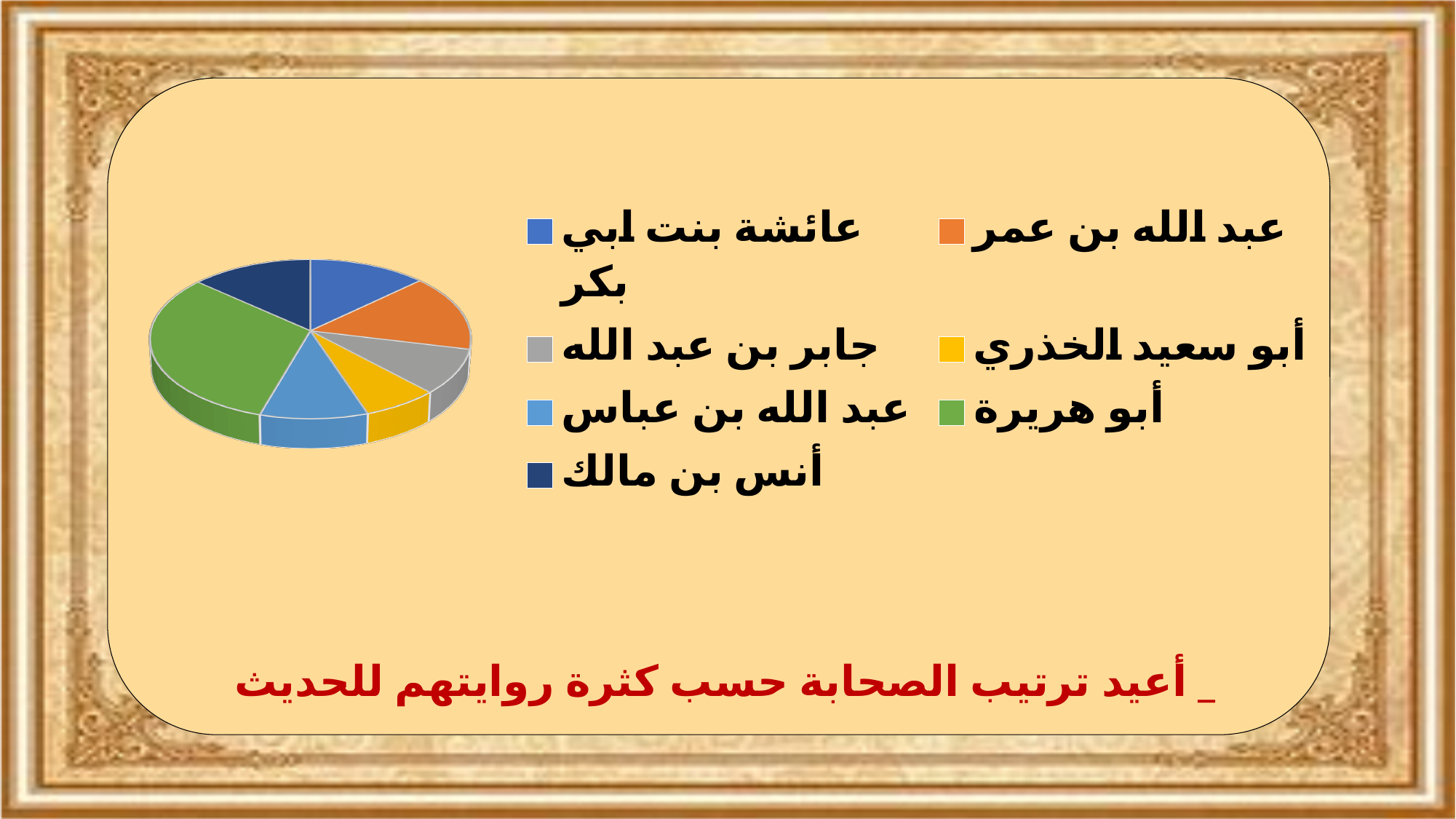
Which legend entry is shown with an orange marker? عبد الله بن عمر Which slice is larger, أبو هريرة or أنس بن مالك? أبو هريرة How many entries does the legend of the pie chart list? 7 Which category has the largest slice in the pie chart? أبو هريرة Which slice is larger, عائشة بنت ابي بكر or أبو سعيد الخذري? عائشة بنت ابي بكر What kind of chart is shown on the slide? pie chart What colour is the slice for أبو هريرة in the pie chart? green Which slice is larger, أبو هريرة or عبد الله بن عمر? أبو هريرة How many slices does the pie chart have? 7